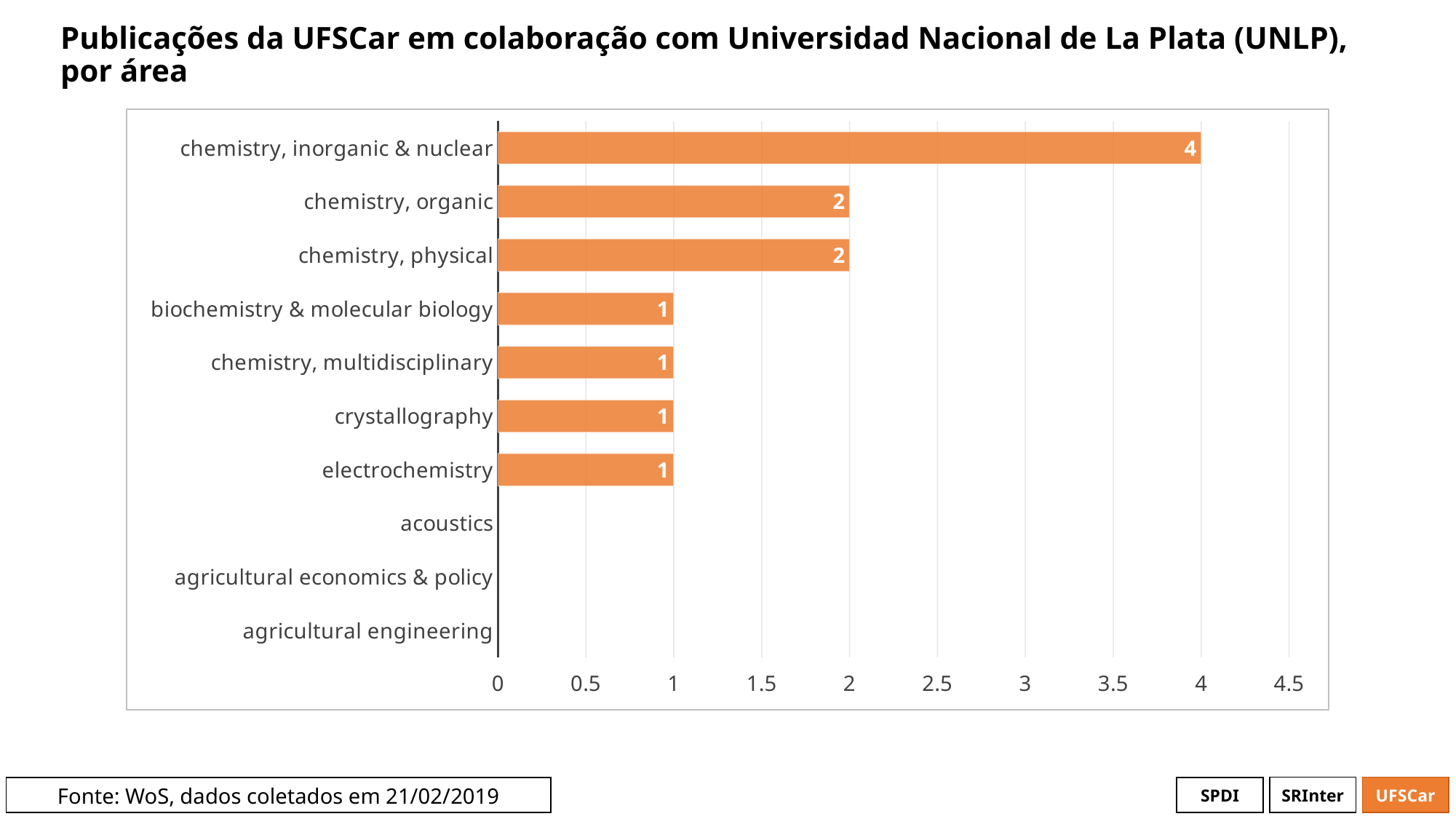
What is the value for electrochemistry? 1 What kind of chart is shown on the slide? bar chart Which is larger, the value for chemistry, organic or the value for crystallography? chemistry, organic How many categories have a value of 1? 4 What is the highest tick value shown on the horizontal axis? 4.5 Is the value for chemistry, inorganic & nuclear greater or less than 3? greater What is the value for chemistry, organic? 2 What is the difference between the values for chemistry, inorganic & nuclear and chemistry, physical? 2 Which category has the highest value? chemistry, inorganic & nuclear What is the source cited at the bottom of the slide? WoS, dados coletados em 21/02/2019 How many categories are listed on the vertical axis? 10 What is the value for chemistry, inorganic & nuclear? 4